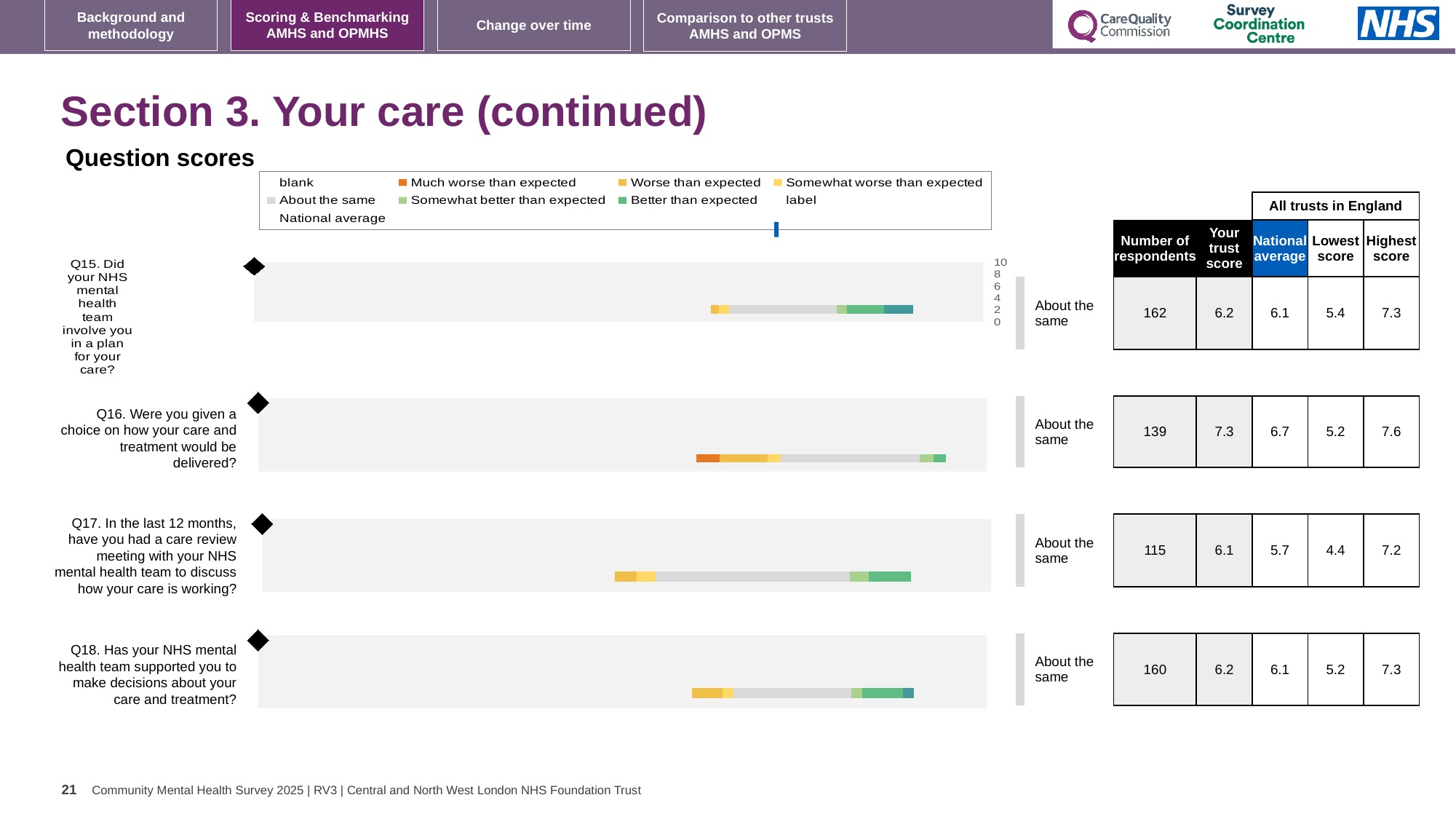
What benchmark category label is shown next to the bar for Q16? About the same What is the number of respondents for Q16 (Were you given a choice on how your care and treatment would be delivered)? 139 For Q15, which is larger: the trust score or the national average? the trust score What is the trust score for Q17 (care review meeting in the last 12 months)? 6.1 What is the difference between the trust score and the national average for Q16? 0.6 Which question has the highest trust score? Q16 What colour does the legend use for 'Much worse than expected'? orange How many questions (Q15 to Q18) have a score bar plotted on the slide? 4 What is the national average for Q18 (supported to make decisions about your care and treatment)? 6.1 What kind of chart is used to show the question scores for Q15 to Q18? bar chart What is the lowest score among all trusts in England for Q17? 4.4 Which question has the lowest number of respondents? Q17